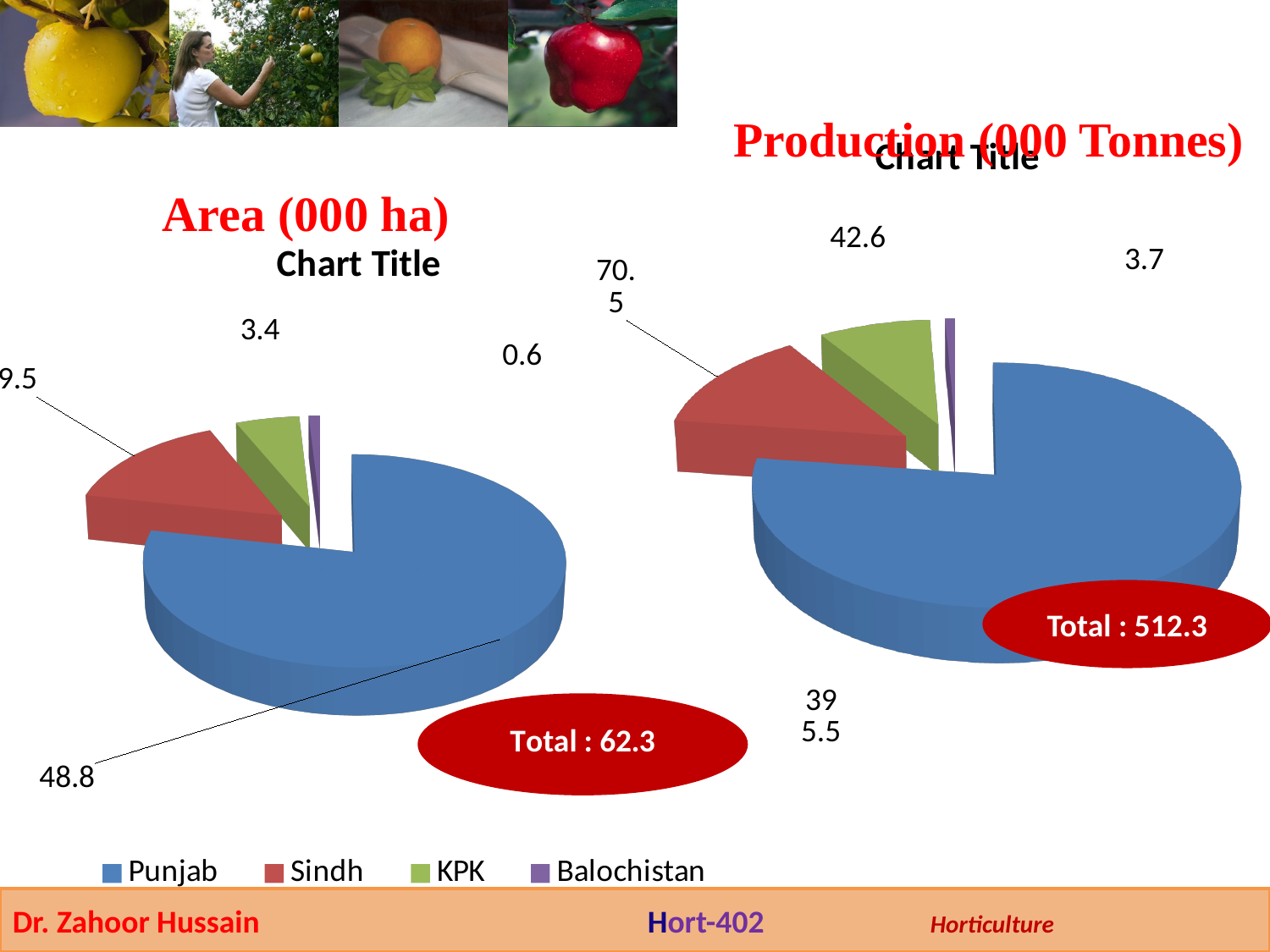
In the Area (000 ha) chart, what total is shown? 62.3 In the Production (000 Tonnes) chart, which is larger, the value for KPK or the value for Balochistan? KPK In the Area (000 ha) chart, what is the value for KPK? 3.4 In the Production (000 Tonnes) chart, what is the value for KPK? 42.6 In the Production (000 Tonnes) chart, what is the value for Balochistan? 3.7 In the Area (000 ha) chart, which province has the largest slice? Punjab In the Area (000 ha) chart, what is the value for Punjab? 48.8 What kind of charts are shown on the slide? Pie charts In the Area (000 ha) chart, what is the value for Balochistan? 0.6 In the Production (000 Tonnes) chart, what total is shown? 512.3 In the Area (000 ha) chart, what is the difference between the values for Punjab and Sindh? 39.3 In the Area (000 ha) chart, which province has the smallest slice? Balochistan